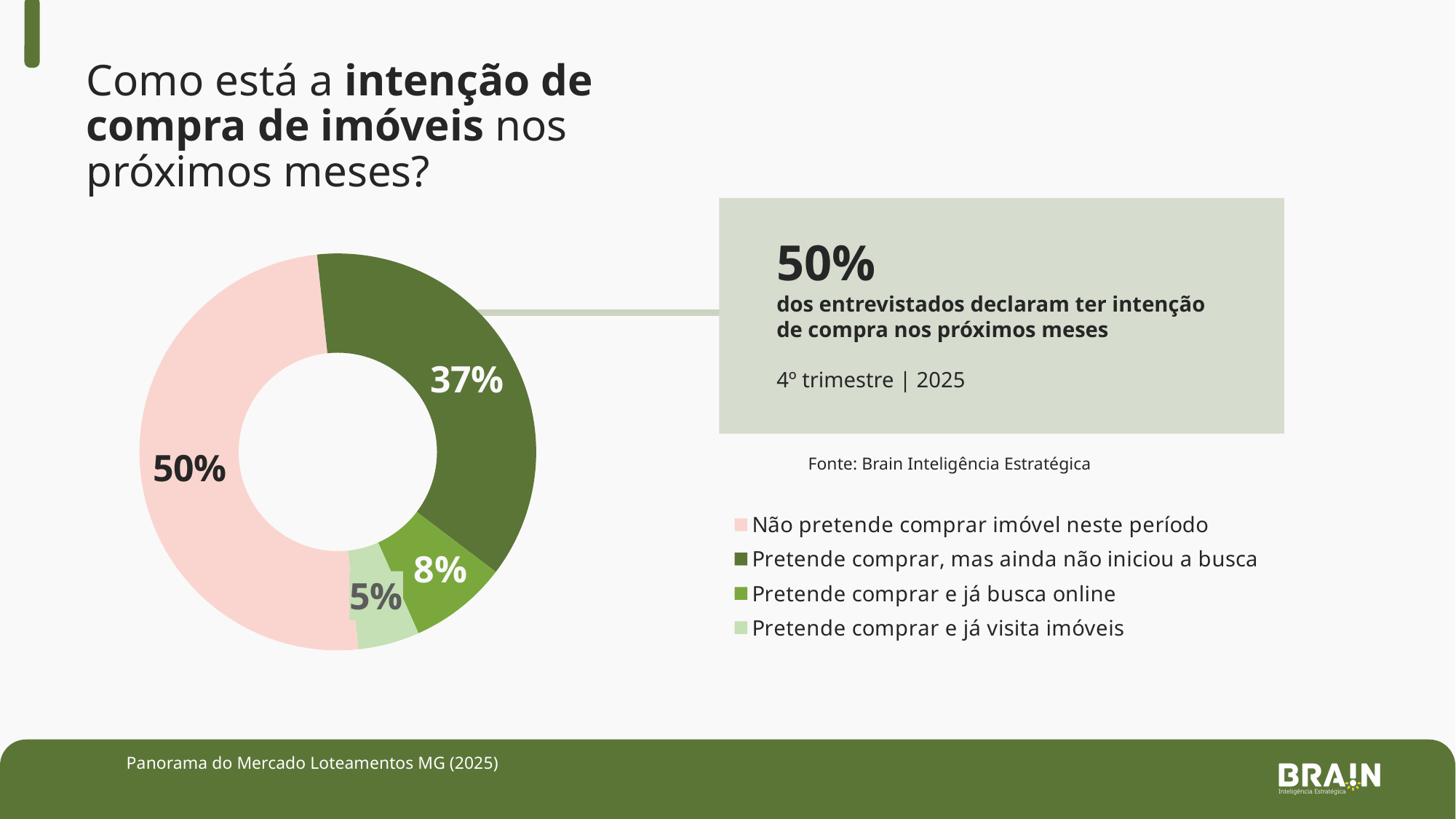
What type of chart is shown on the slide? Donut (pie) chart What percentage of respondents do not intend to buy property in this period ("Não pretende comprar imóvel neste período")? 50% Which category has the largest share of the donut chart? Não pretende comprar imóvel neste período What percentage of respondents intend to buy and are already visiting properties ("Pretende comprar e já visita imóveis")? 5% What is the difference in percentage points between "Não pretende comprar imóvel neste período" and "Pretende comprar, mas ainda não iniciou a busca"? 13 percentage points What is the combined share of the three categories that intend to buy (37%, 8% and 5%)? 50% Which colour represents "Não pretende comprar imóvel neste período" in the legend? Light pink Which category has the smallest share of the donut chart? Pretende comprar e já visita imóveis What percentage of respondents intend to buy and are already searching online ("Pretende comprar e já busca online")? 8% How many categories does the donut chart show? 4 Which is larger: the share for "Pretende comprar e já busca online" or the share for "Pretende comprar e já visita imóveis"? Pretende comprar e já busca online What percentage of respondents intend to buy but have not yet started searching ("Pretende comprar, mas ainda não iniciou a busca")? 37%